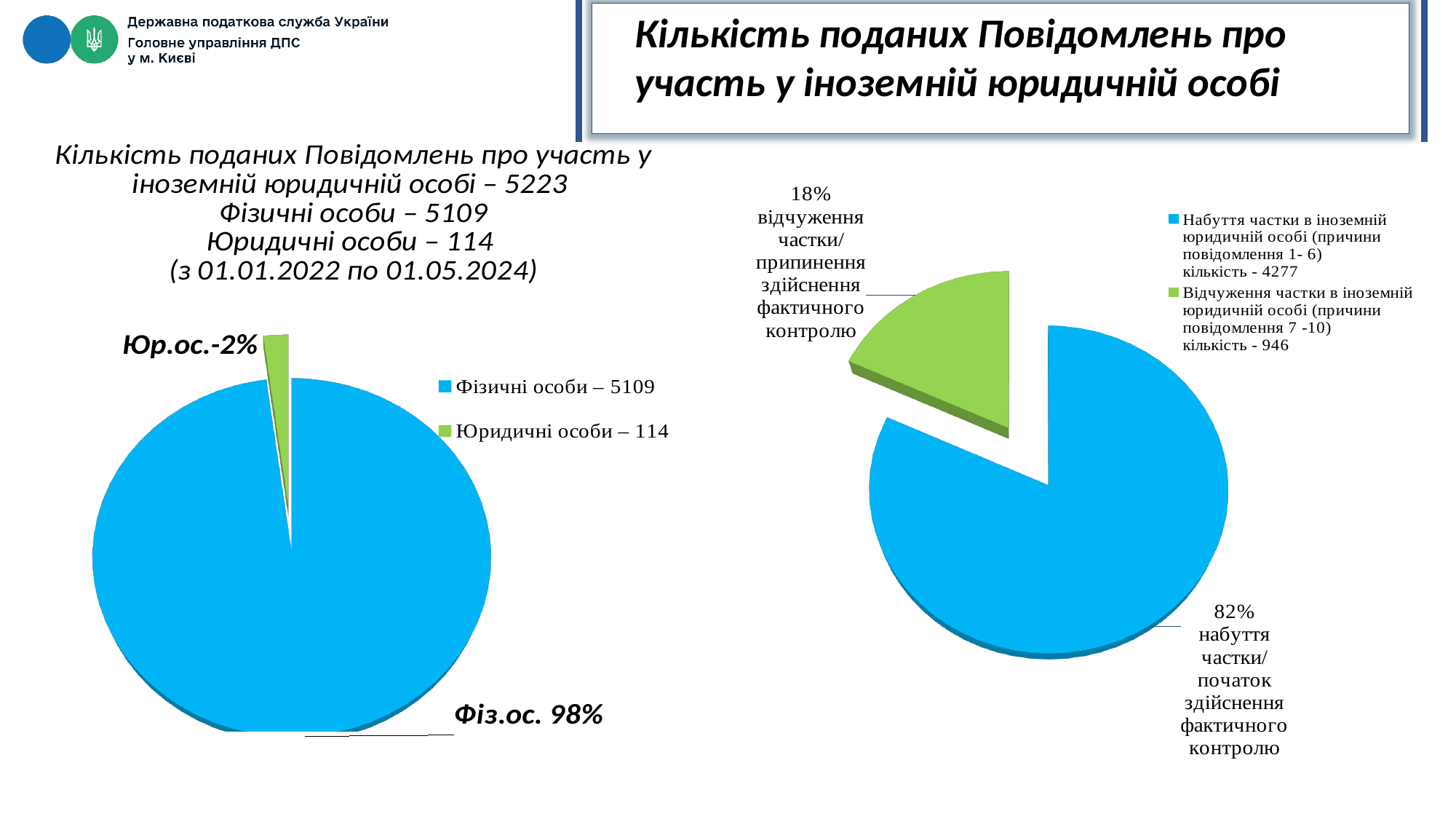
How many entries does the legend of the left pie chart list? 2 In the right pie chart, what share of the pie is відчуження частки/припинення здійснення фактичного контролю? 18% In the right pie chart, which slice is smaller: набуття частки or відчуження частки? відчуження частки In the left pie chart, what share of the pie is Фіз.ос.? 98% In the left pie chart, what is the value for Юридичні особи? 114 What type of chart is the left chart on the slide? pie chart In the left pie chart, what is the difference between Фізичні особи and Юридичні особи? 4995 In the left pie chart, which category is the largest? Фізичні особи In the left pie chart, what share of the pie is Юр.ос.? 2% In the left pie chart, what is the value for Фізичні особи? 5109 In the right pie chart, what is the кількість for Набуття частки в іноземній юридичній особі? 4277 In the right pie chart, what is the кількість for Відчуження частки в іноземній юридичній особі? 946